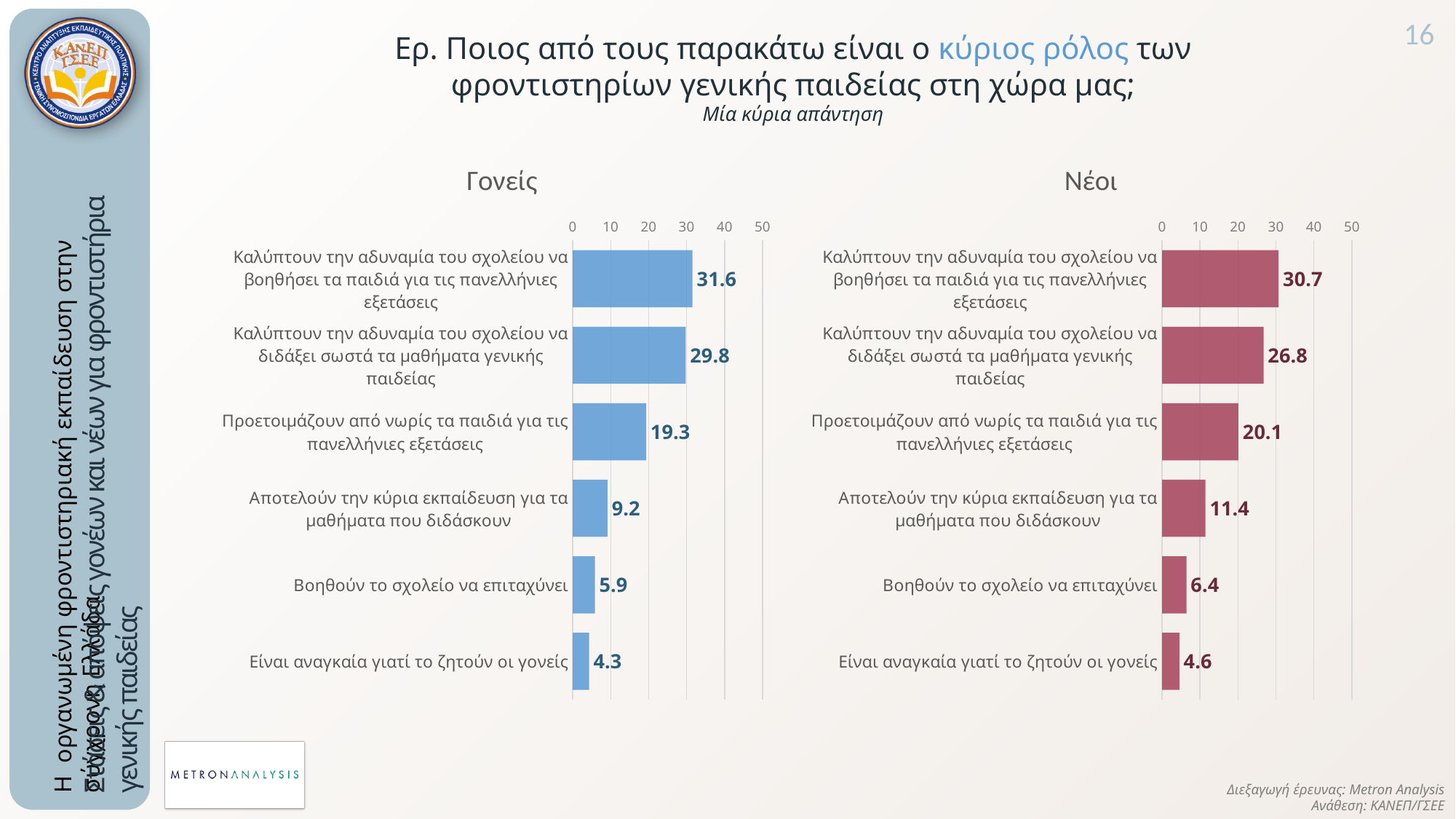
In the Γονείς chart, what is the difference between the values for 'Καλύπτουν την αδυναμία του σχολείου να βοηθήσει τα παιδιά για τις πανελλήνιες εξετάσεις' and 'Καλύπτουν την αδυναμία του σχολείου να διδάξει σωστά τα μαθήματα γενικής παιδείας'? 1.8 What kind of chart is the Γονείς chart? bar chart Which is larger for 'Αποτελούν την κύρια εκπαίδευση για τα μαθήματα που διδάσκουν': the Γονείς value or the Νέοι value? Νέοι In the Νέοι chart, what is the value for 'Αποτελούν την κύρια εκπαίδευση για τα μαθήματα που διδάσκουν'? 11.4 How many categories are shown in the Νέοι chart? 6 In the Νέοι chart, what is the difference between the values for 'Βοηθούν το σχολείο να επιταχύνει' and 'Είναι αναγκαία γιατί το ζητούν οι γονείς'? 1.8 In the Νέοι chart, which category has the highest value? Καλύπτουν την αδυναμία του σχολείου να βοηθήσει τα παιδιά για τις πανελλήνιες εξετάσεις In the Γονείς chart, what is the value for 'Καλύπτουν την αδυναμία του σχολείου να βοηθήσει τα παιδιά για τις πανελλήνιες εξετάσεις'? 31.6 In the Γονείς chart, is the value for 'Προετοιμάζουν από νωρίς τα παιδιά για τις πανελλήνιες εξετάσεις' greater or less than 20? less In the Νέοι chart, what is the value for 'Προετοιμάζουν από νωρίς τα παιδιά για τις πανελλήνιες εξετάσεις'? 20.1 What colour are the bars in the Νέοι chart? red In the Γονείς chart, which category has the lowest value? Είναι αναγκαία γιατί το ζητούν οι γονείς